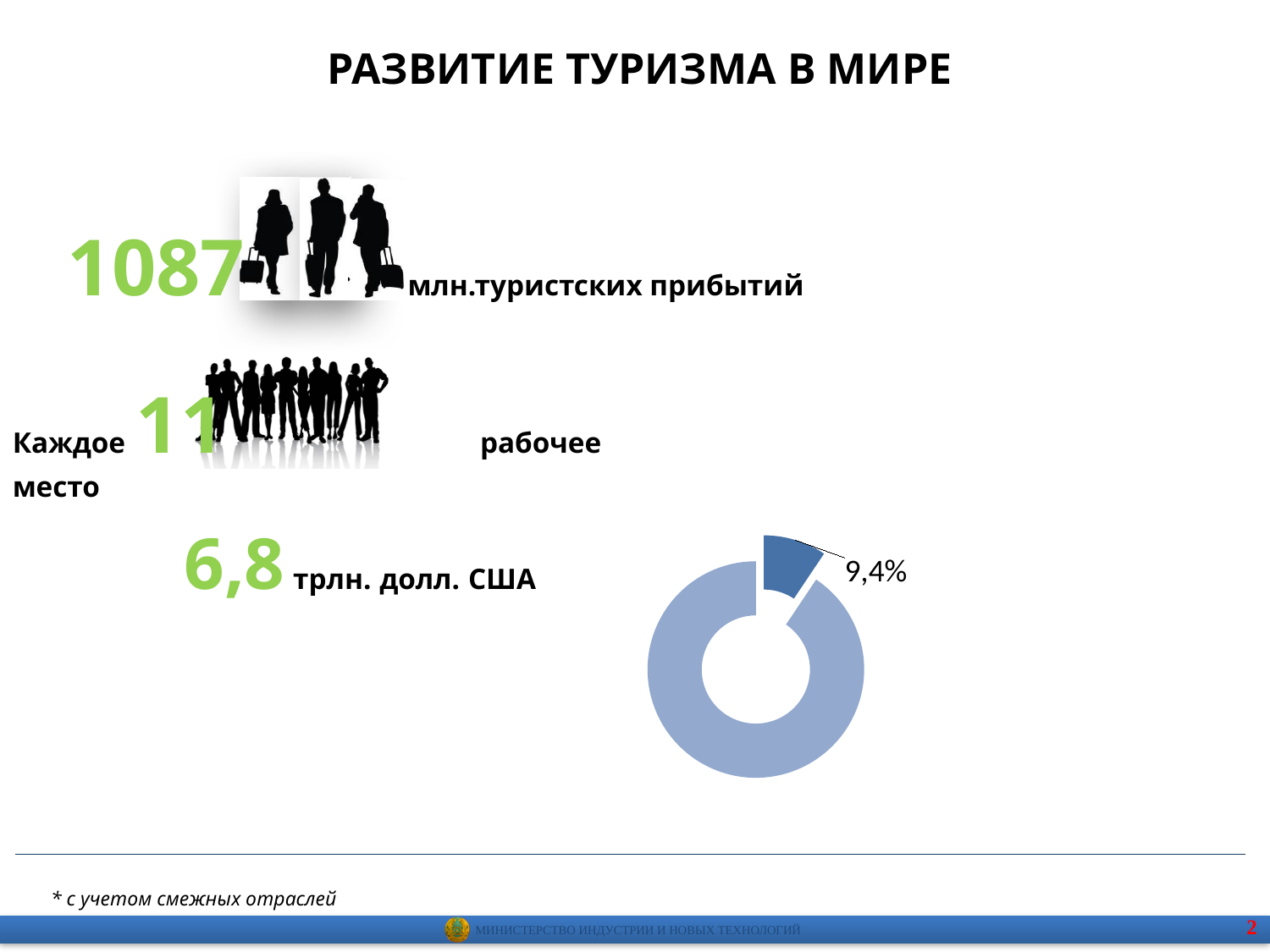
What kind of chart is shown on the slide? doughnut chart What share of the doughnut chart does the dark blue slice represent? 9,4% What colour is the slice labelled 9,4% in the doughnut chart? dark blue What value is printed on the labelled slice of the doughnut chart? 9,4% Does the doughnut chart have a legend? No Which slice of the doughnut chart is larger, the dark blue slice or the light blue slice? the light blue slice How many slices does the doughnut chart have? 2